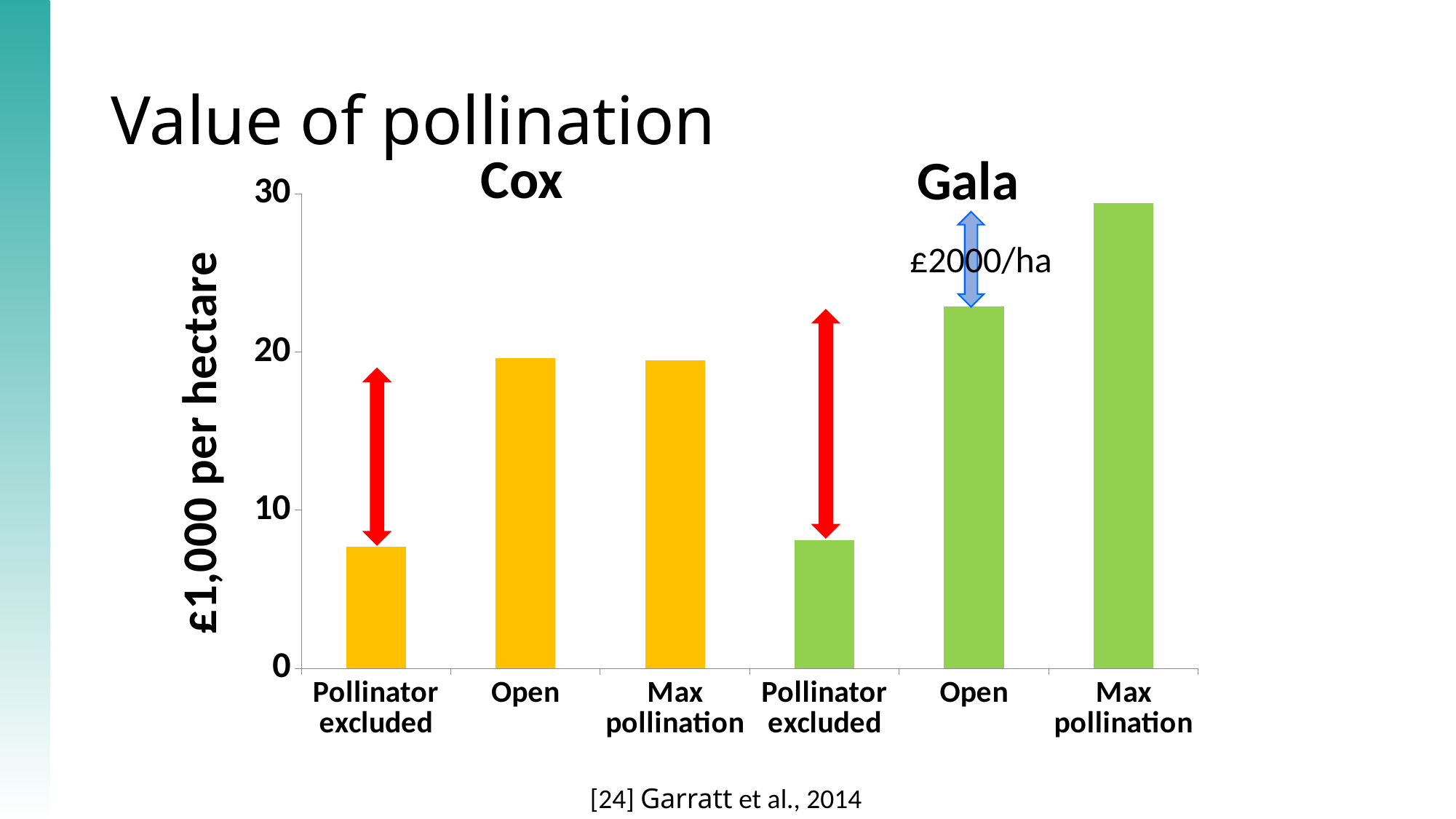
Is the value for Gala Max pollination greater or less than 20? greater What is the label on the vertical axis of the chart? £1,000 per hectare Is the value for Cox Pollinator excluded greater or less than 10? less What kind of chart is shown on the slide? bar chart Is the value for Gala Pollinator excluded greater or less than 10? less Which is larger, the value for Gala Max pollination or the value for Gala Open? Gala Max pollination Which bar is the highest in the chart? Gala Max pollination How many bars are plotted in the chart? 6 Which is larger, the value for Gala Open or the value for Cox Open? Gala Open Which bar is the lowest in the chart? Cox Pollinator excluded What is the title of the slide containing the chart? Value of pollination